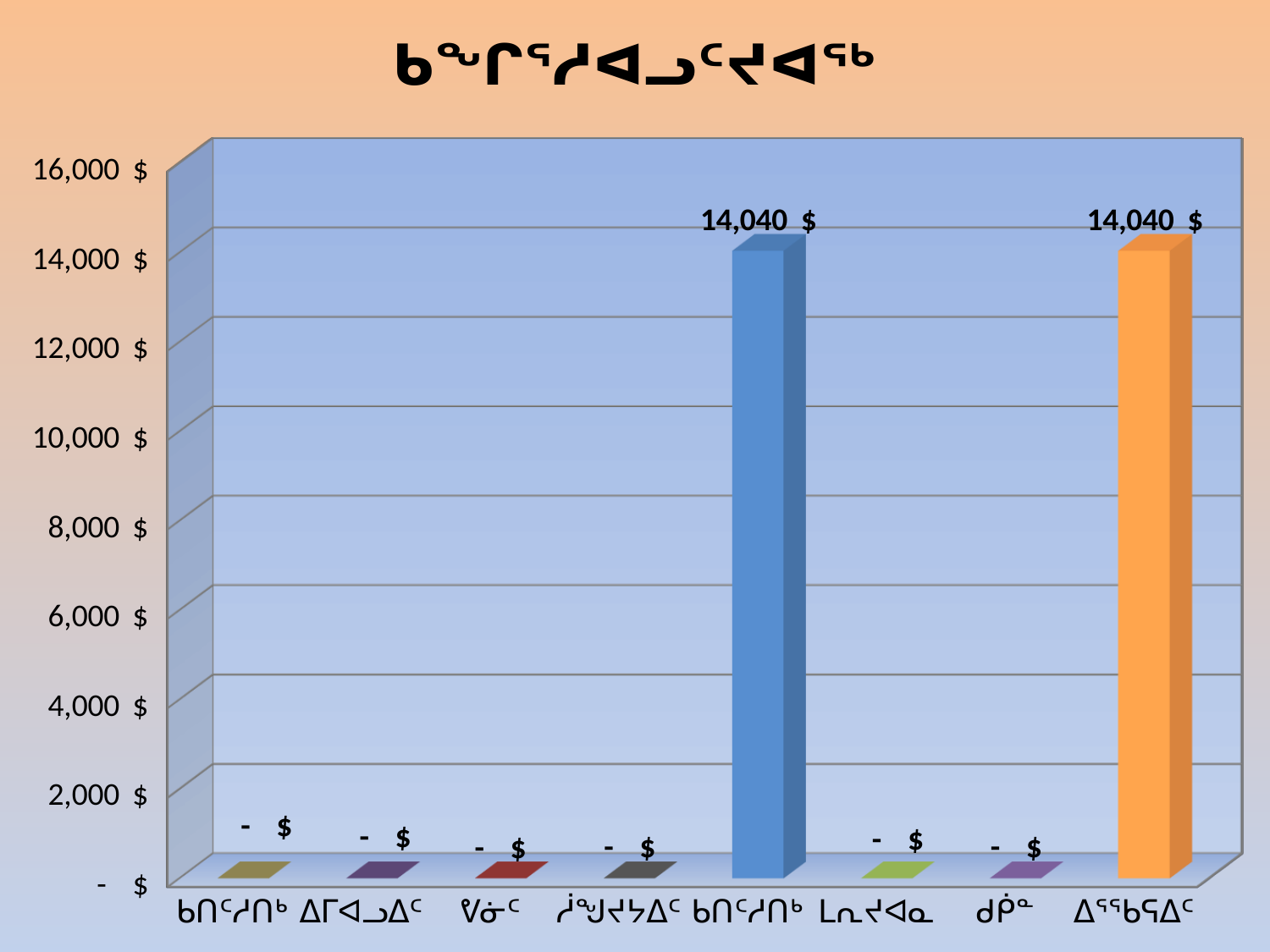
What value is labelled on the leftmost bar? - $ What is the difference between the value of the fifth bar from the left and the value of the rightmost bar? 0 $ Which is larger, the value of the fifth bar from the left or the value of the leftmost bar? the fifth bar from the left What value is labelled on the fifth bar from the left (the blue bar)? 14,040 $ How many categories (bars) are plotted along the x axis? 8 How many bars are labelled 14,040 $? 2 Is the value for the rightmost bar greater or less than 16,000 $? less What kind of chart is shown on the slide? bar chart Is the value for the fifth bar from the left greater or less than 12,000 $? greater What value is labelled on the rightmost bar (the orange bar)? 14,040 $ What is the highest tick value shown on the vertical axis? 16,000 $ How many bars are labelled "- $"? 6